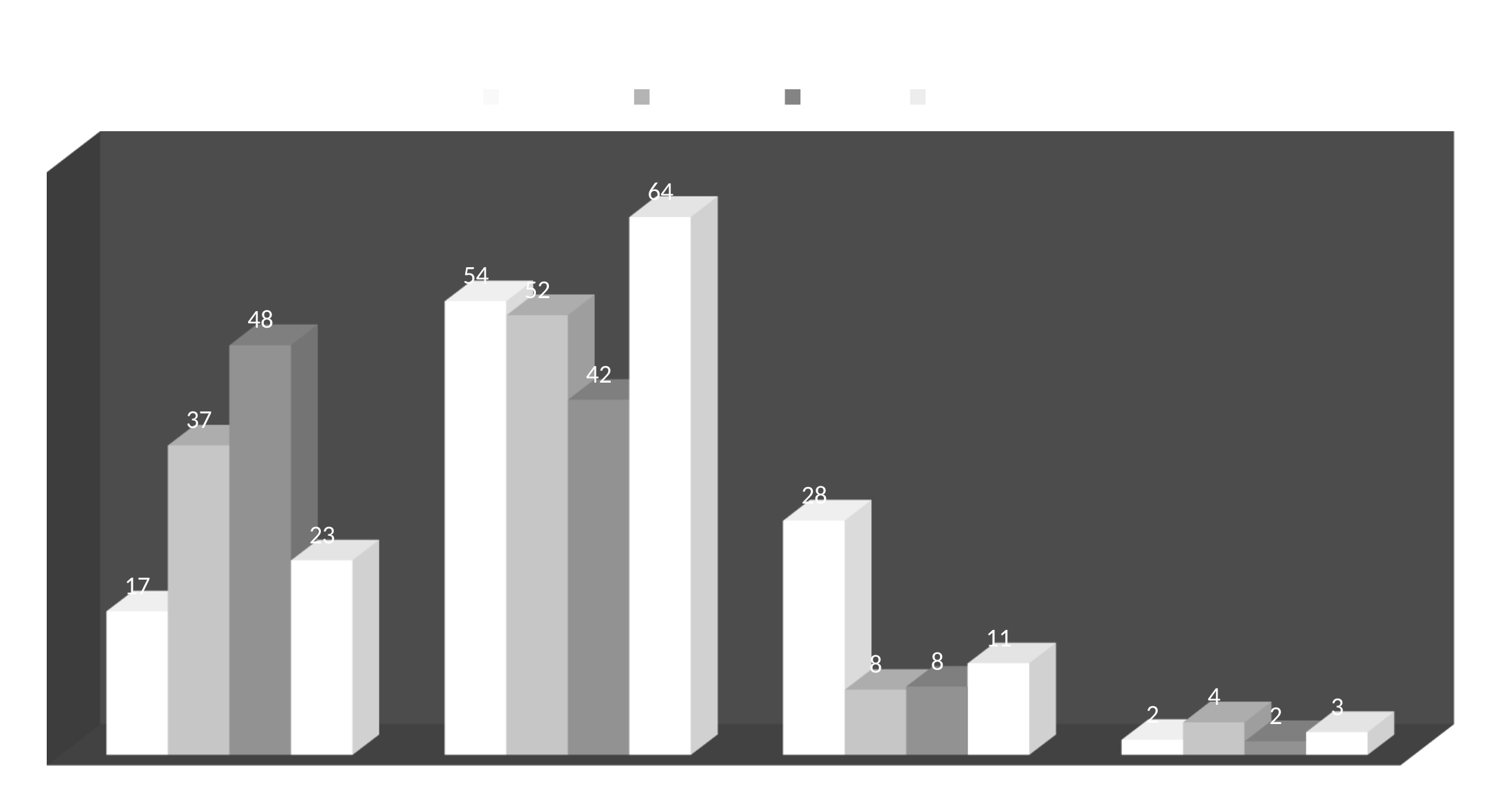
What kind of chart is shown on the slide? bar chart What is the lowest value in the first group of bars? 17 In the third group, which is larger: the first bar or the fourth bar? the first bar Do the values of the first (white) series rise or fall from the second group to the fourth group? fall How many groups of bars are plotted along the x axis? 4 What is the value of the third bar in the second group? 42 What is the value of the first (leftmost) bar in the first group? 17 How many series does the legend list? 4 What is the difference between the fourth bar (64) and the first bar (54) in the second group? 10 What is the value of the second bar in the fourth (rightmost) group? 4 What is the difference between the third bar (48) and the second bar (37) in the first group? 11 What is the highest value labelled on the chart? 64